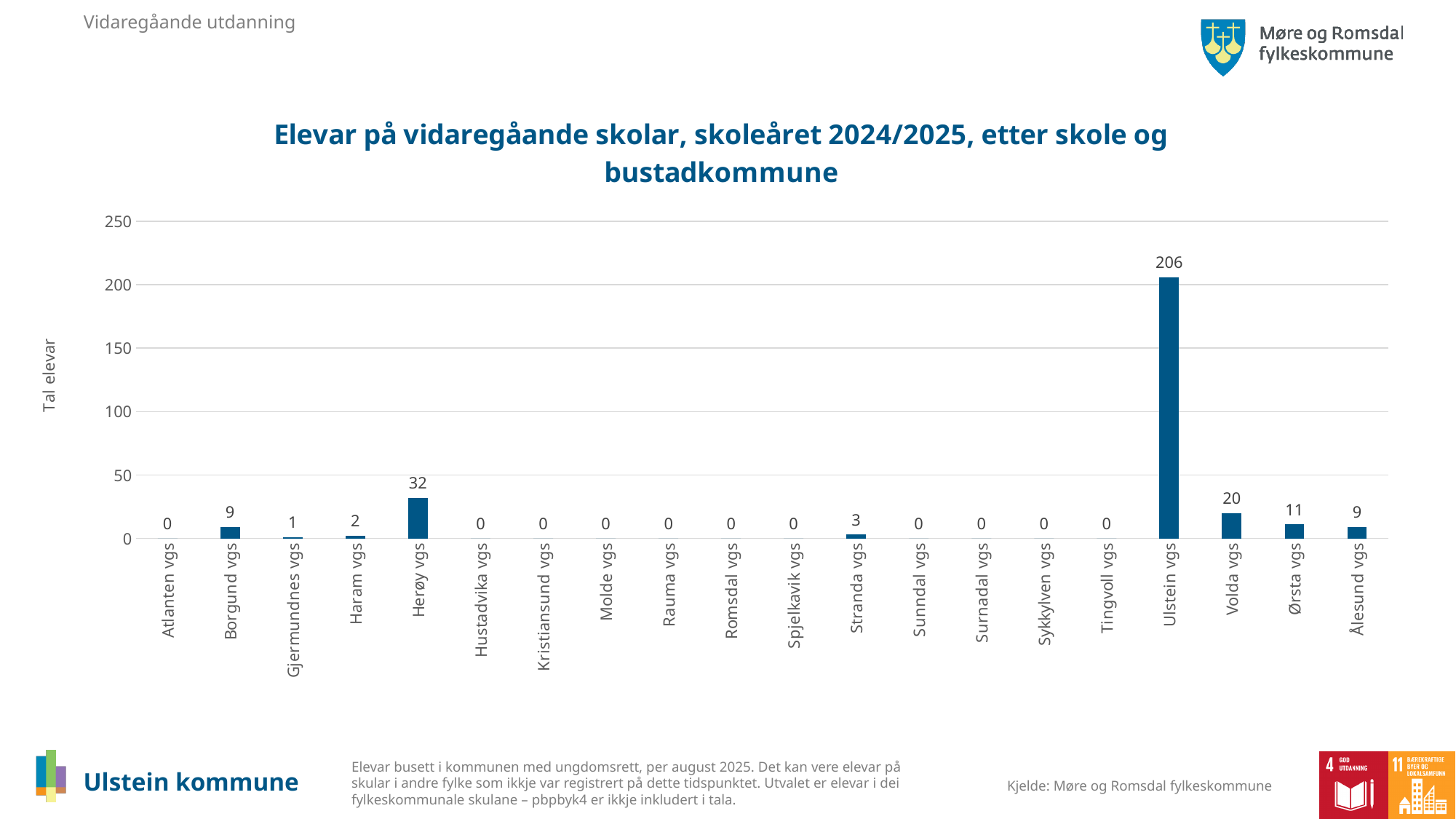
Which is larger, the value for Borgund vgs or the value for Stranda vgs? Borgund vgs What kind of chart is shown on the slide? Bar chart What is the value for Volda vgs? 20 How many schools are shown on the x axis? 20 Which school has the highest number of pupils? Ulstein vgs What is the difference between the values for Volda vgs and Ålesund vgs? 11 Is the value for Ulstein vgs greater or less than 200? greater What is the label of the y axis? Tal elevar What is the value for Herøy vgs? 32 What is the difference between the values for Ulstein vgs and Herøy vgs? 174 What is the value for Ørsta vgs? 11 What is the value for Ulstein vgs? 206